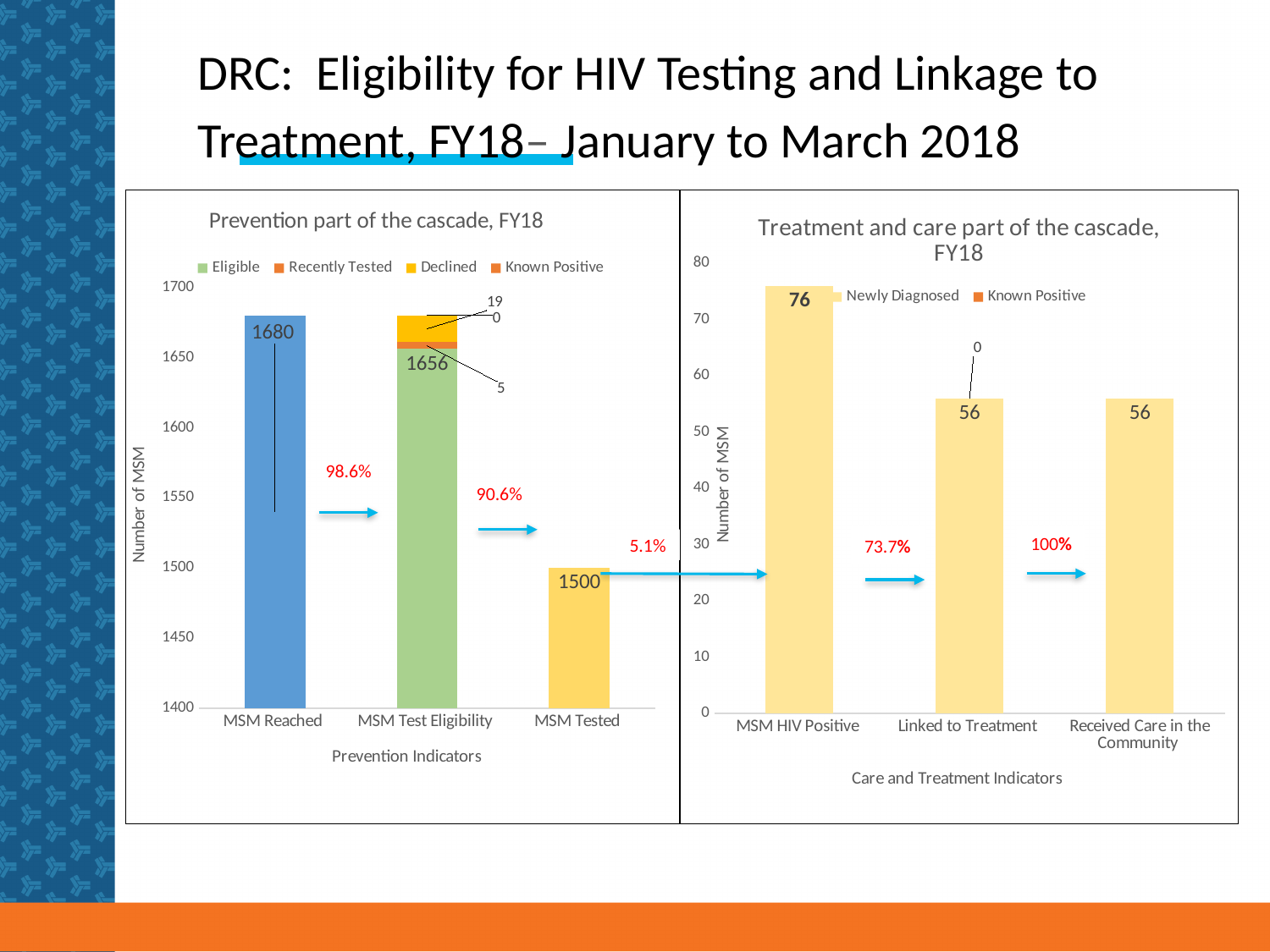
In the 'Prevention part of the cascade, FY18' chart, what is the value for MSM Tested? 1500 In the 'Treatment and care part of the cascade, FY18' chart, which category has the highest value? MSM HIV Positive In the 'Prevention part of the cascade, FY18' chart, what is the value for MSM Reached? 1680 In the 'Prevention part of the cascade, FY18' chart, what is the Declined value for MSM Test Eligibility? 19 In the 'Treatment and care part of the cascade, FY18' chart, what is the value for Linked to Treatment? 56 In the 'Prevention part of the cascade, FY18' chart, what is the Eligible value for MSM Test Eligibility? 1656 In the 'Treatment and care part of the cascade, FY18' chart, what is the value for MSM HIV Positive? 76 In the 'Treatment and care part of the cascade, FY18' chart, what is the difference between MSM HIV Positive and Linked to Treatment? 20 In the 'Prevention part of the cascade, FY18' chart, how many series does the legend list? 4 What kind of chart is the 'Treatment and care part of the cascade, FY18' chart? Bar chart In the 'Prevention part of the cascade, FY18' chart, what is the difference between MSM Reached and MSM Tested? 180 In the 'Treatment and care part of the cascade, FY18' chart, how many categories are shown on the x axis? 3